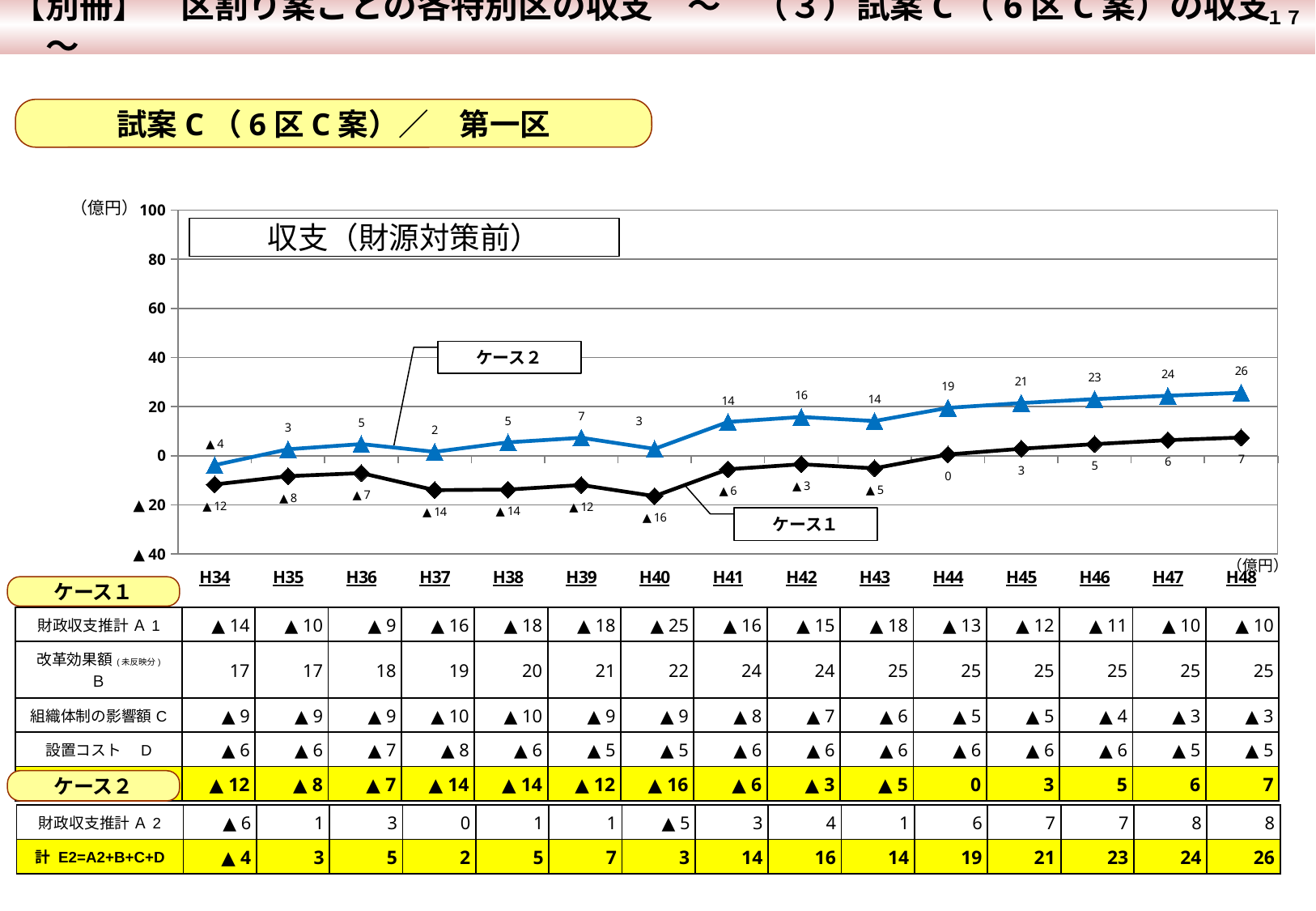
What is the difference between ケース2 and ケース1 at H45? 18 What is the title of the chart? 収支（財源対策前） What kind of chart is shown? line chart What is the value for ケース2 at H41? 14 In which year does ケース2 reach its highest value? H48 What is the value for ケース1 at H44? 0 How many series are plotted in the chart? 2 In which year is ケース1 at its lowest value? H40 How many years are plotted on the x axis? 15 Which series has the larger value at H42, ケース1 or ケース2? ケース2 What is the value for ケース1 at H40? ▲16 What is the value for ケース2 at H48? 26